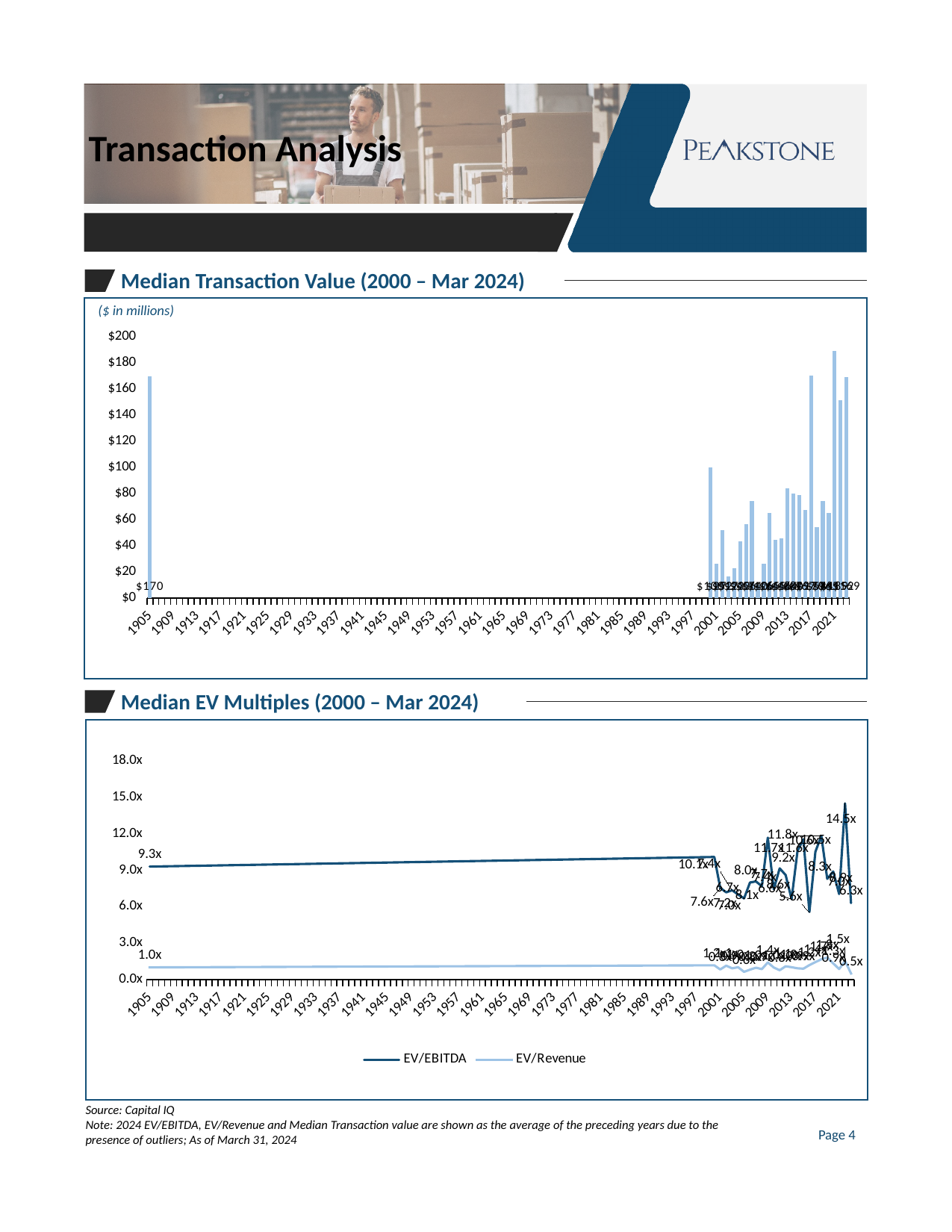
In the Median EV Multiples chart, what is the EV/Revenue value at 1905? 1.0x In the Median EV Multiples chart, what is the difference between the EV/EBITDA and EV/Revenue values at 1905? 8.3x In the Median Transaction Value chart, what is the value of the bar at 1905? $170 How many series does the legend of the Median EV Multiples chart list? 2 In the Median Transaction Value chart, what unit note is shown above the chart? ($ in millions) What kind of chart is the Median Transaction Value (2000 – Mar 2024) chart? bar chart In the Median EV Multiples chart, what is the EV/EBITDA value at 1905? 9.3x What are the two series named in the legend of the Median EV Multiples chart? EV/EBITDA and EV/Revenue In the Median EV Multiples chart, which series is larger at 1905, EV/EBITDA or EV/Revenue? EV/EBITDA In the Median EV Multiples chart, what is the highest labeled EV/EBITDA value? 14.5x What kind of chart is the Median EV Multiples (2000 – Mar 2024) chart? line chart In the Median Transaction Value chart, is the value of the tallest bar after 2000 greater or less than $180? greater